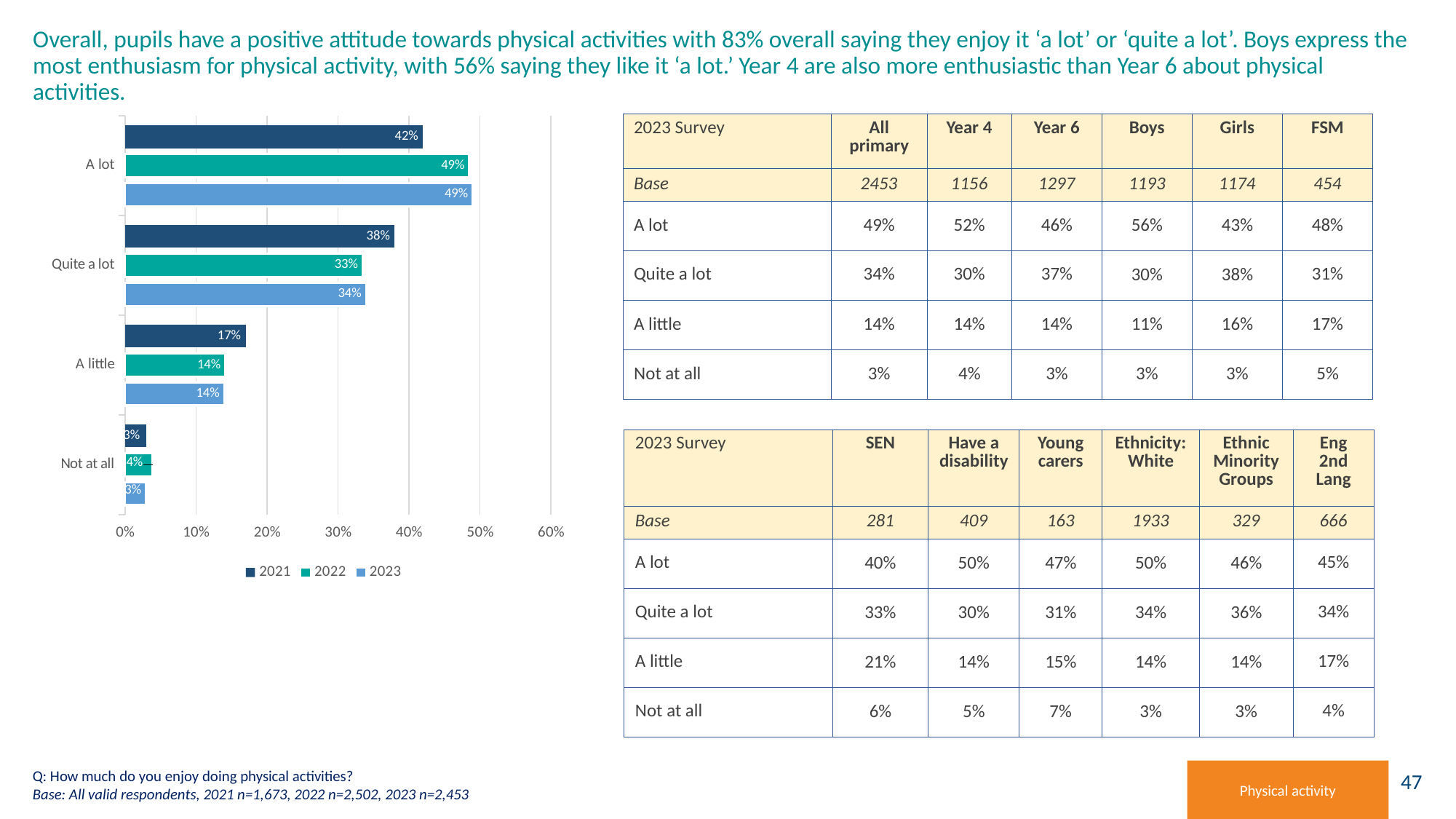
Which category has the lowest 2021 value in the bar chart? Not at all What type of chart is shown on the left of the slide? Bar chart What is the 2022 value for 'Not at all' in the bar chart? 4% What is the 2023 value for 'Quite a lot' in the bar chart? 34% Which years are listed in the legend of the bar chart? 2021, 2022, 2023 What is the difference between the 2021 and 2023 values for 'A lot' in the bar chart? 7 percentage points What is the 2022 value for 'A little' in the bar chart? 14% How many categories are shown on the bar chart's vertical axis? 4 In the bar chart, is the 2021 value for 'Quite a lot' larger or smaller than the 2022 value for 'Quite a lot'? larger How many series does the legend of the bar chart list? 3 Which category has the highest 2023 value in the bar chart? A lot What is the 2021 value for 'A lot' in the bar chart? 42%